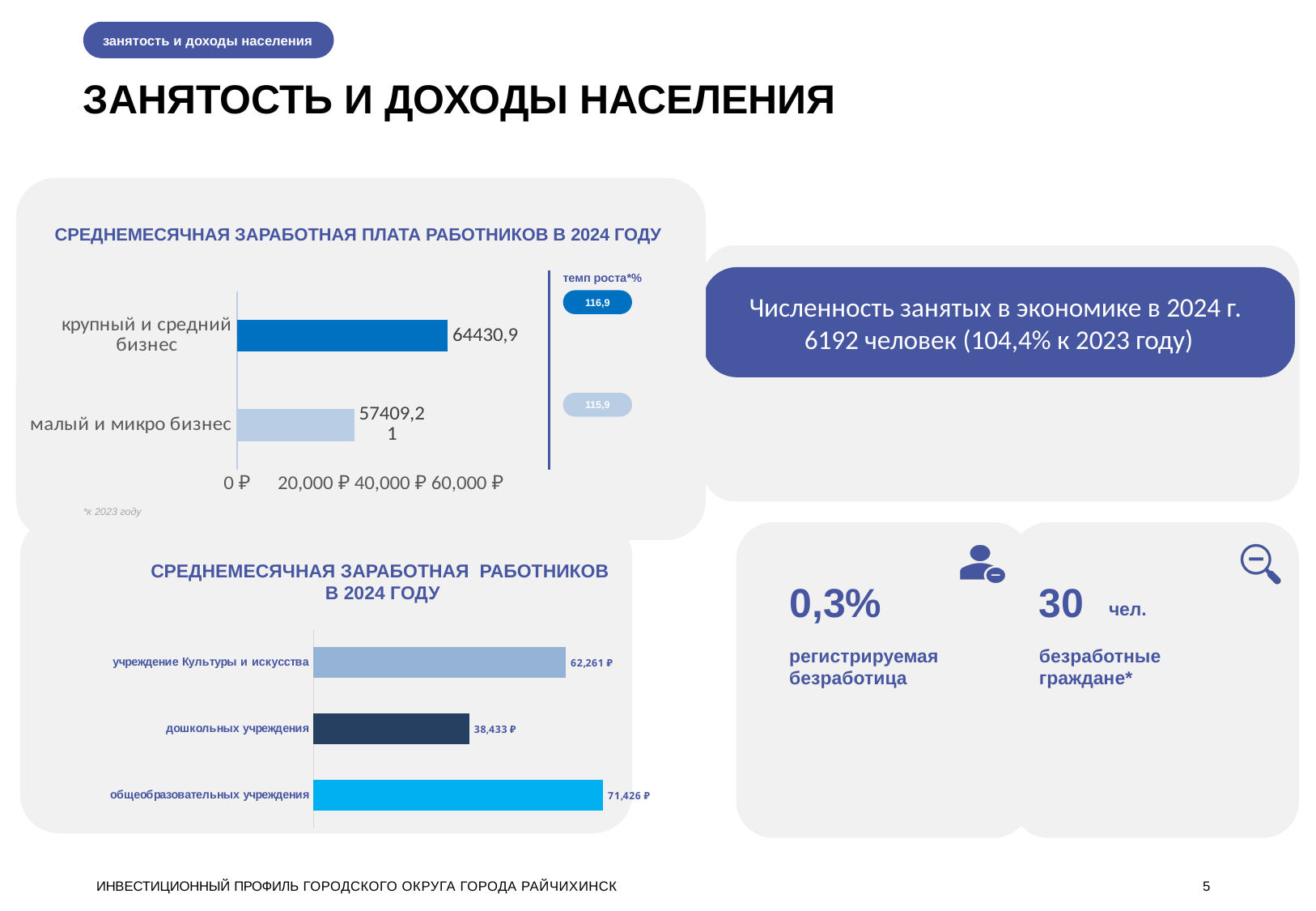
In the top-left chart, which category has the higher average monthly salary? крупный и средний бизнес In the top-left chart, what is the difference between the salary for крупный и средний бизнес and малый и микро бизнес? 7021,69 In the top-left chart (average monthly salary of workers in 2024), what is the value for крупный и средний бизнес? 64430,9 How many categories are shown in the bottom-left chart? 3 In the top-left chart (average monthly salary of workers in 2024), what is the value for малый и микро бизнес? 57409,21 In the bottom-left chart, what is the value for учреждение Культуры и искусства? 62,261 ₽ In the bottom-left chart, what is the value for дошкольных учреждения? 38,433 ₽ In the bottom-left chart, which category has the lowest average monthly salary? дошкольных учреждения In the bottom-left chart (average monthly salary of workers in 2024), what is the value for общеобразовательных учреждения? 71,426 ₽ In the bottom-left chart, what is the difference between the salary for общеобразовательных учреждения and дошкольных учреждения? 32,993 ₽ What type of chart is the top-left chart? bar chart